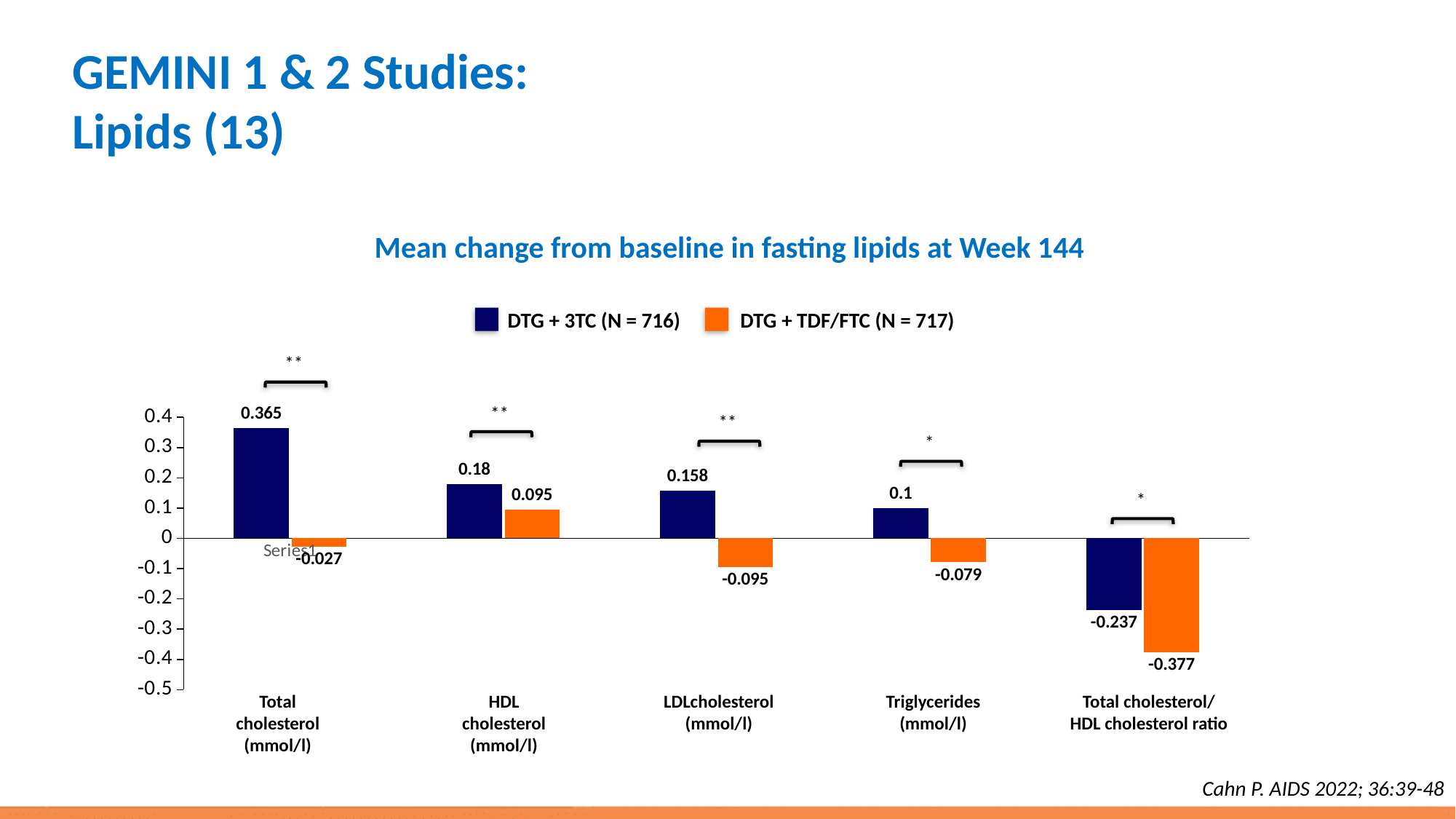
For the total cholesterol/HDL cholesterol ratio, which arm has the larger (less negative) value, DTG + 3TC or DTG + TDF/FTC? DTG + 3TC What type of chart is shown on the slide? Bar chart What is the mean change from baseline in LDL cholesterol for DTG + TDF/FTC (N = 717)? -0.095 What is the mean change from baseline in the total cholesterol/HDL cholesterol ratio for DTG + TDF/FTC (N = 717)? -0.377 Is the DTG + 3TC value for total cholesterol greater or less than 0.3? greater What is the mean change from baseline in total cholesterol for DTG + 3TC (N = 716)? 0.365 What is the mean change from baseline in triglycerides for DTG + 3TC (N = 716)? 0.1 Which lipid category has the lowest value for DTG + TDF/FTC (N = 717)? Total cholesterol/HDL cholesterol ratio How many series does the legend list? 2 How many lipid categories are shown on the x axis? 5 Which lipid category has the highest value for DTG + 3TC (N = 716)? Total cholesterol (mmol/l) What is the difference between the DTG + 3TC and DTG + TDF/FTC values for HDL cholesterol? 0.085